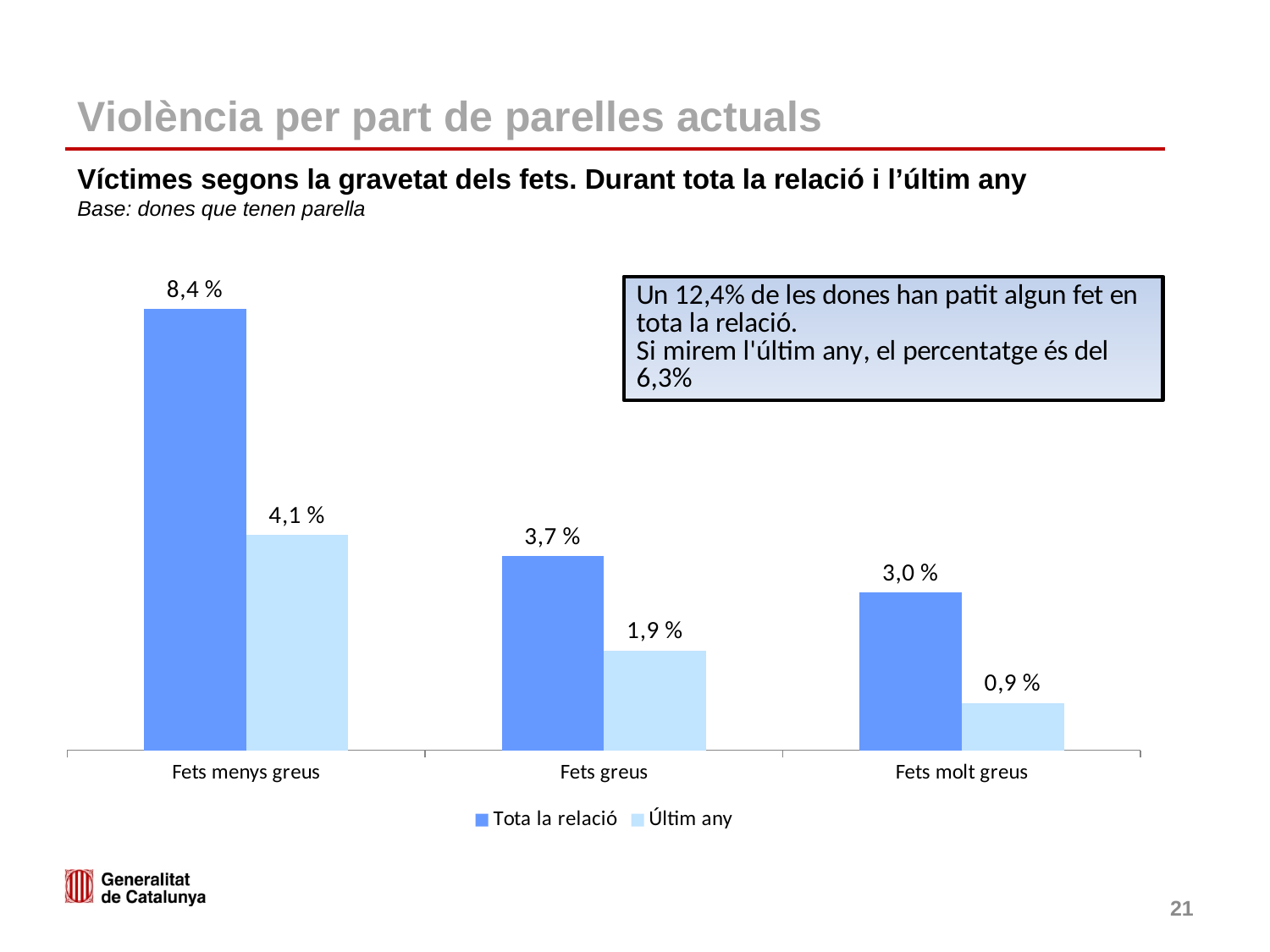
How many categories are shown on the x axis? 3 How many series does the legend list? 2 What is the value for 'Últim any' in the 'Fets greus' category? 1,9 % What is the difference between 'Tota la relació' for 'Fets greus' and 'Tota la relació' for 'Fets molt greus'? 0,7 % What is the difference between 'Tota la relació' and 'Últim any' in the 'Fets menys greus' category? 4,3 % Do the 'Tota la relació' values rise or fall from left to right along the x axis? Fall Which category has the highest value for 'Tota la relació'? Fets menys greus Which category has the lowest value for 'Últim any'? Fets molt greus What is the value for 'Tota la relació' in the 'Fets menys greus' category? 8,4 % Which is larger: 'Últim any' for 'Fets menys greus' or 'Tota la relació' for 'Fets greus'? Últim any for Fets menys greus What kind of chart is shown on the slide? Bar chart What is the value for 'Últim any' in the 'Fets molt greus' category? 0,9 %